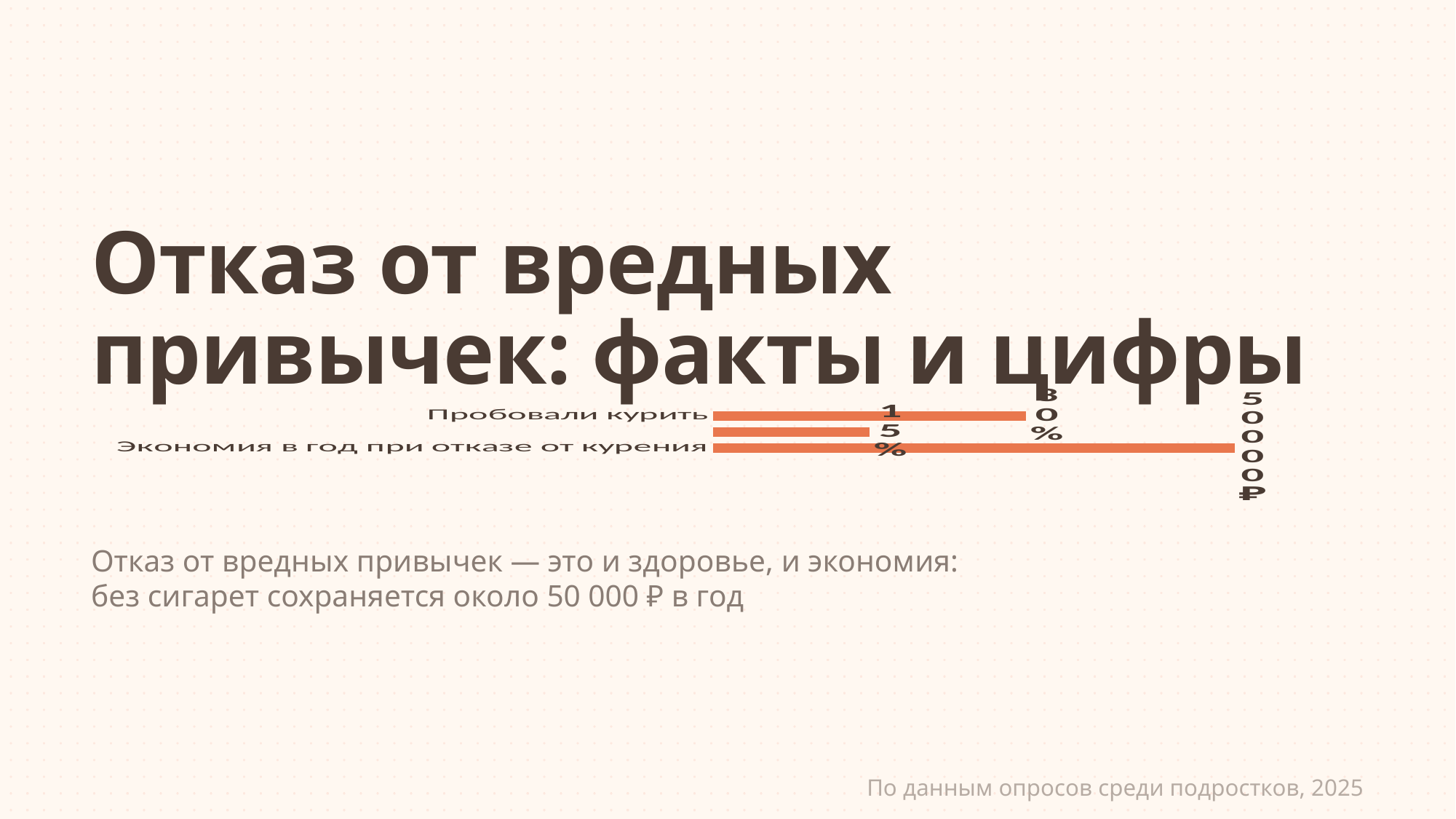
What colour are the bars in the chart? orange Which bar is longer: "Пробовали курить" or "Экономия в год при отказе от курения"? Экономия в год при отказе от курения What is the value shown for "Экономия в год при отказе от курения"? 50000 ₽ What is the value shown for "Пробовали курить"? 30% Are the bars in the chart horizontal or vertical? horizontal What kind of chart is shown on the slide? bar chart Which category has the longest bar in the chart? Экономия в год при отказе от курения How many bars does the chart show? 3